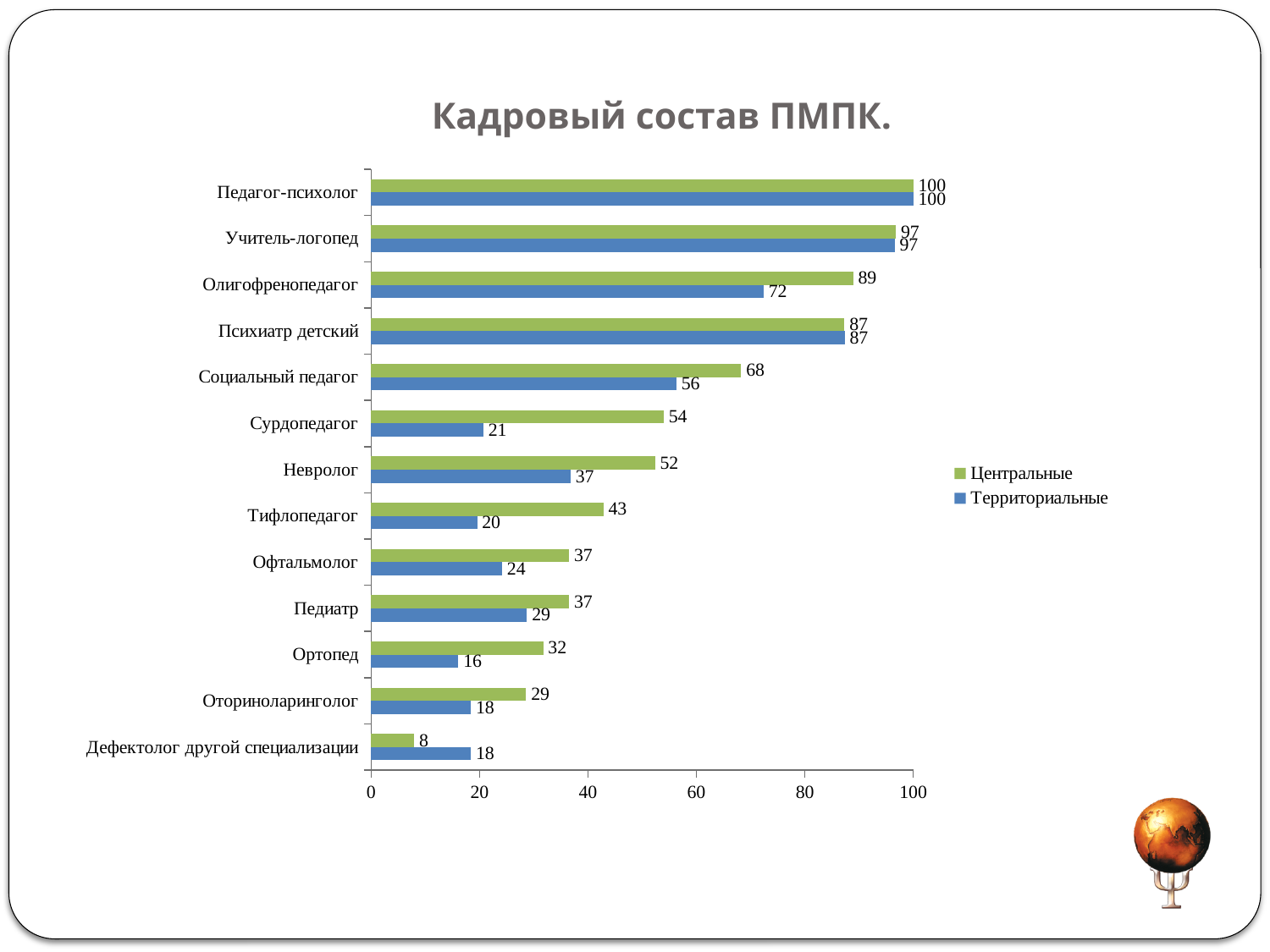
How many series does the legend list? 2 How many categories are shown on the chart? 13 What kind of chart is shown on the slide? Bar chart What is the value for Территориальные for Сурдопедагог? 21 Which category has the highest value for Территориальные? Педагог-психолог What is the difference between the Центральные and Территориальные values for Тифлопедагог? 23 Which is larger for Невролог: Центральные or Территориальные? Центральные What is the value for Центральные for Олигофренопедагог? 89 What is the value for Территориальные for Социальный педагог? 56 Which is larger for Дефектолог другой специализации: Центральные or Территориальные? Территориальные Which category has the lowest value for Центральные? Дефектолог другой специализации What is the title of the chart? Кадровый состав ПМПК.